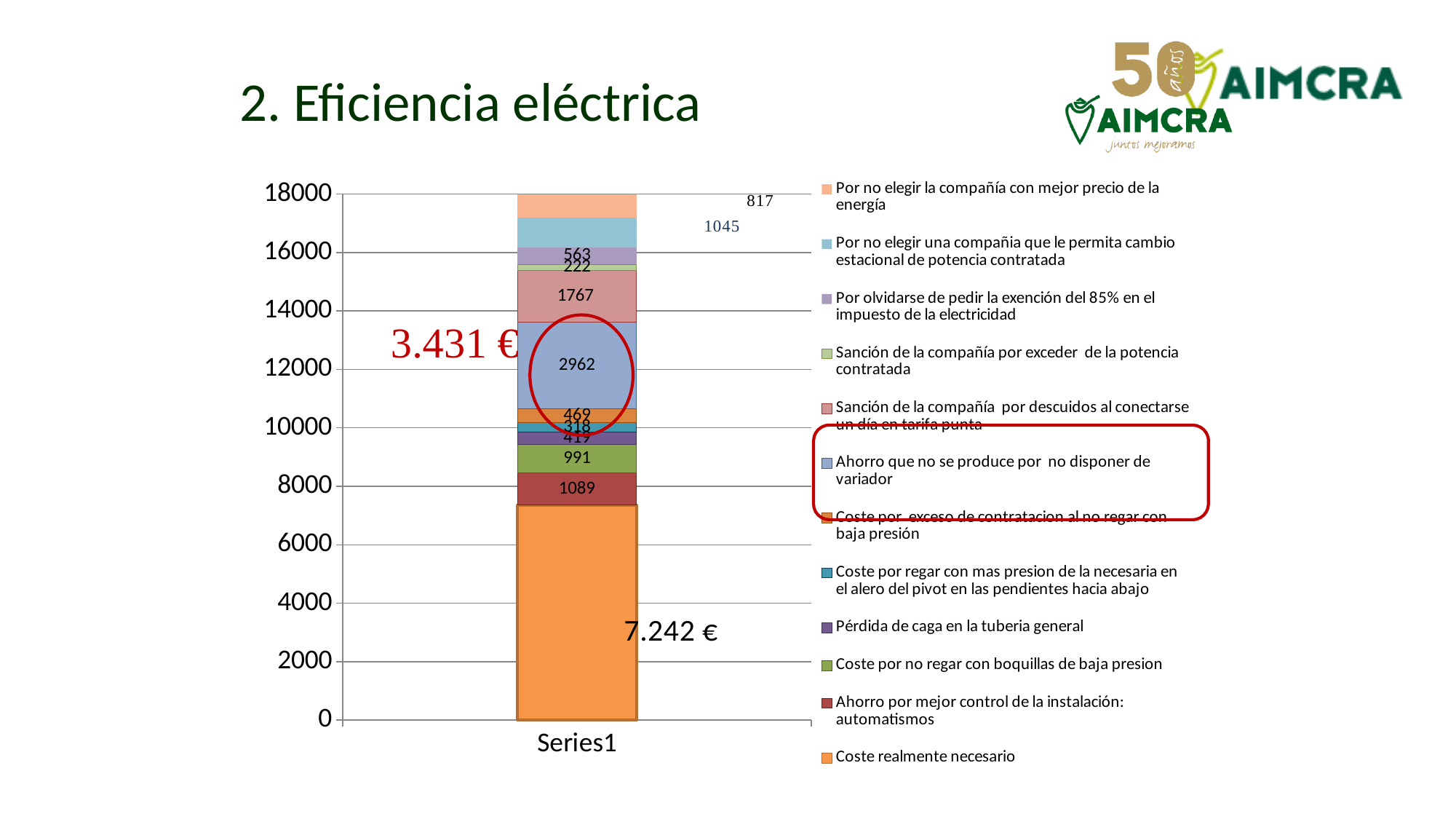
How many categories are plotted on the x axis? 1 Which segment of the stacked bar is the largest? Coste realmente necesario How many series does the legend list? 12 What is the difference between the 'Ahorro que no se produce por no disponer de variador' segment and the 'Sanción de la compañía por descuidos al conectarse un día en tarifa punta' segment? 1195 Is the value of the 'Coste realmente necesario' segment greater or less than 8000? less What is the value of the segment 'Ahorro que no se produce por no disponer de variador'? 2962 What is the value of the segment 'Sanción de la compañía por descuidos al conectarse un día en tarifa punta'? 1767 What kind of chart is shown on the slide? Stacked bar chart What is the value of the segment 'Coste por exceso de contratacion al no regar con baja presión'? 469 What is the value of the segment 'Ahorro por mejor control de la instalación: automatismos'? 1089 What is the value of the segment 'Por no elegir la compañía con mejor precio de la energía'? 817 Which is larger: 'Coste por no regar con boquillas de baja presion' or 'Ahorro por mejor control de la instalación: automatismos'? Ahorro por mejor control de la instalación: automatismos